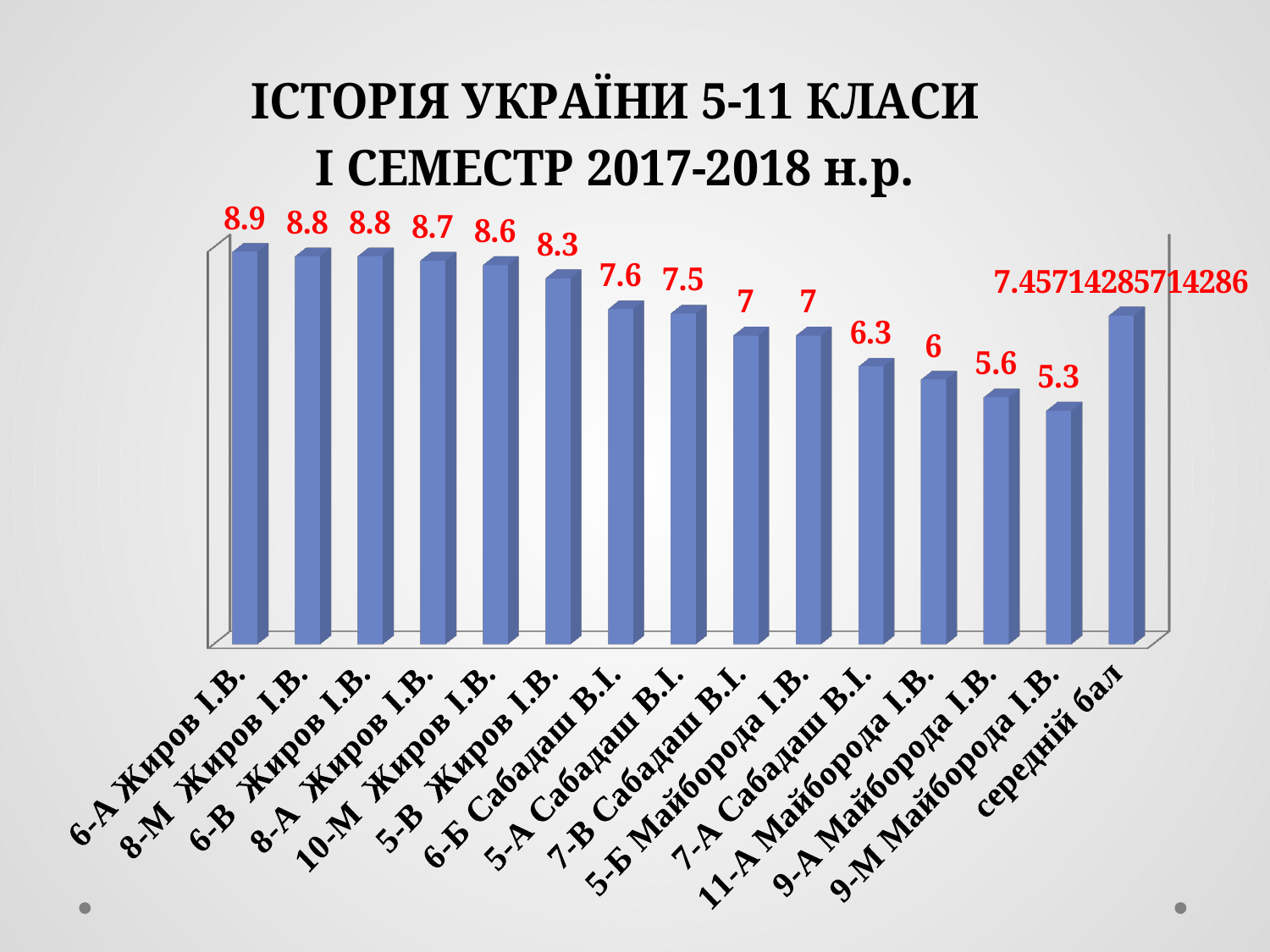
What kind of chart is shown on the slide? Bar chart What is the value shown for середній бал? 7.45714285714286 What is the difference between the values for 6-А Жиров І.В. and 9-М Майборода І.В.? 3.6 What is the value for 6-А Жиров І.В.? 8.9 What is the title of the chart? ІСТОРІЯ УКРАЇНИ 5-11 КЛАСИ І СЕМЕСТР 2017-2018 н.р. Which category has the lowest value? 9-М Майборода І.В. What is the value for 9-М Майборода І.В.? 5.3 Which is larger, the value for 5-В Жиров І.В. or the value for 5-А Сабадаш В.І.? 5-В Жиров І.В. What is the value for 7-А Сабадаш В.І.? 6.3 How many bars are plotted in the chart? 15 What is the difference between the values for 6-Б Сабадаш В.І. and 11-А Майборода І.В.? 1.6 Which category has the highest value? 6-А Жиров І.В.